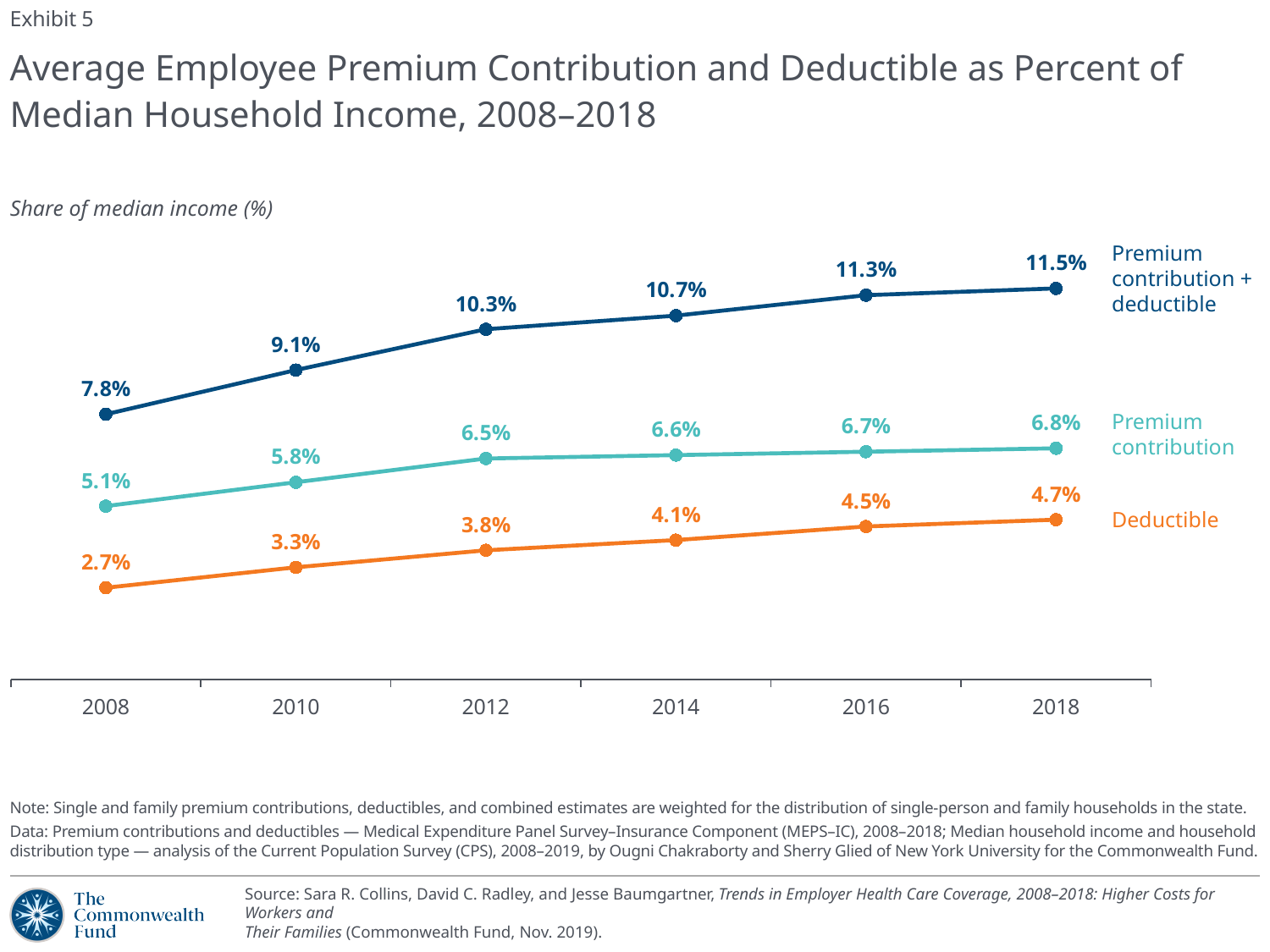
What was the premium contribution + deductible as a share of median income in 2008? 7.8% In which year was the deductible share lowest? 2008 What is the difference between the premium contribution share and the deductible share in 2012? 2.7 percentage points What kind of chart is shown on the slide? Line chart In which year was the premium contribution + deductible share highest? 2018 What was the deductible as a share of median income in 2014? 4.1% Does the deductible share rise or fall from 2008 to 2018? Rise What was the premium contribution as a share of median income in 2018? 6.8% How many series are shown on the chart? 3 How many years are plotted on the x axis? 6 Which was larger in 2016: the premium contribution share or the deductible share? Premium contribution By how many percentage points did the premium contribution + deductible share change from 2008 to 2018? 3.7 percentage points